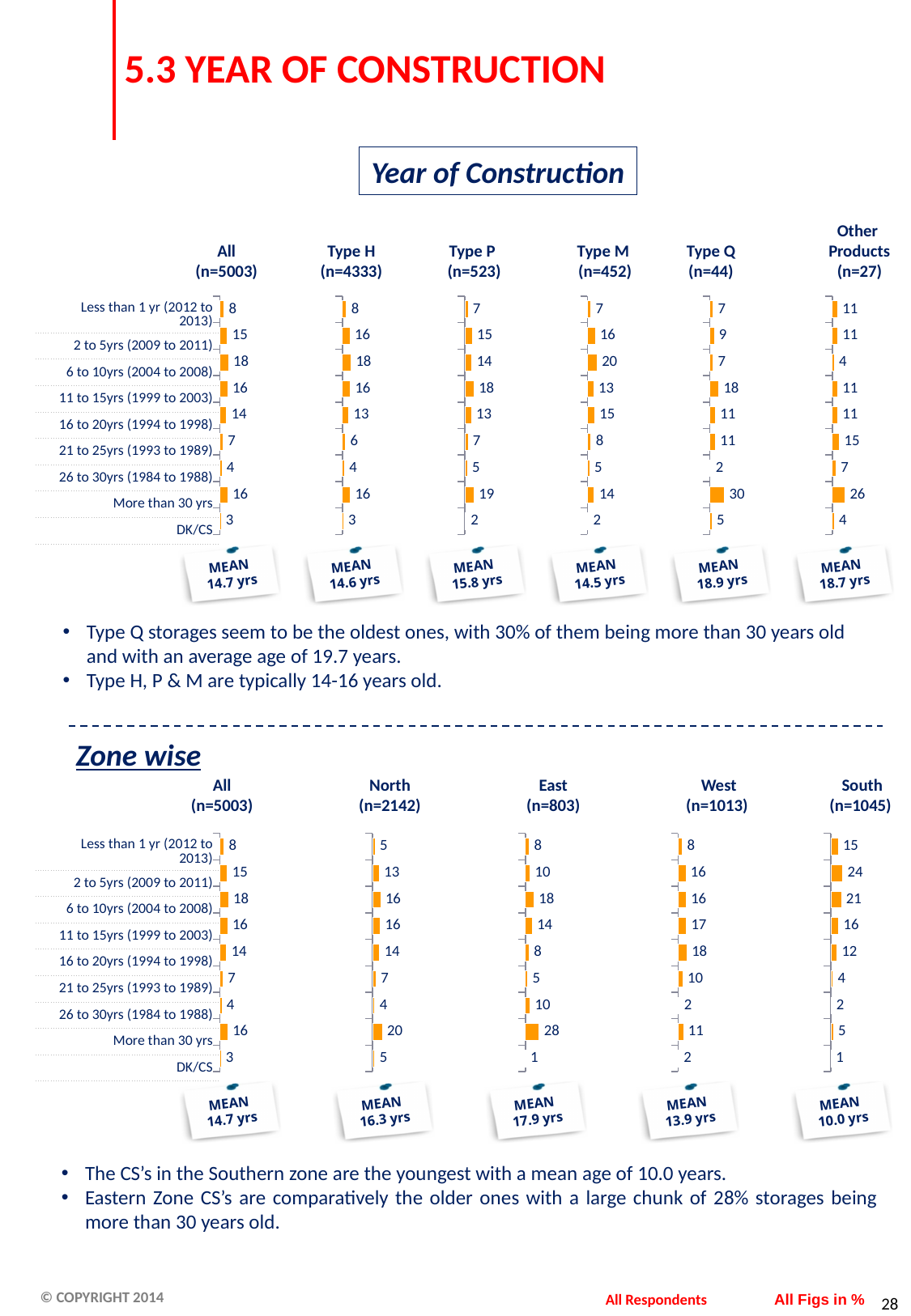
How many year-of-construction categories are plotted in each panel of the top 'Year of Construction' chart? 9 In the top 'Year of Construction' chart, what is the sample size shown for Type H? n=4333 In the top 'Year of Construction' chart, what is the value for '11 to 15yrs (1999 to 2003)' in the Type P (n=523) panel? 18 What kind of chart is used in the 'Zone wise' section? Bar chart In the bottom 'Zone wise' chart, what is the value for 'More than 30 yrs' in the East (n=803) panel? 28 In the bottom 'Zone wise' chart, what mean age is shown for the South zone? 10.0 yrs In the bottom 'Zone wise' chart, what is the difference between the '2 to 5yrs (2009 to 2011)' values for South and East? 14 In the top 'Year of Construction' chart, what is the value for 'More than 30 yrs' in the Type Q (n=44) panel? 30 In the top 'Year of Construction' chart, which category has the lowest value in the Type Q (n=44) panel? 26 to 30yrs (1984 to 1988) In the top 'Year of Construction' chart, what is the difference between the '6 to 10yrs (2004 to 2008)' values for Type M and Type Q? 13 In the bottom 'Zone wise' chart, which zone has the larger value for 'More than 30 yrs', North or West? North In the bottom 'Zone wise' chart, which category has the highest value in the South (n=1045) panel? 2 to 5yrs (2009 to 2011)